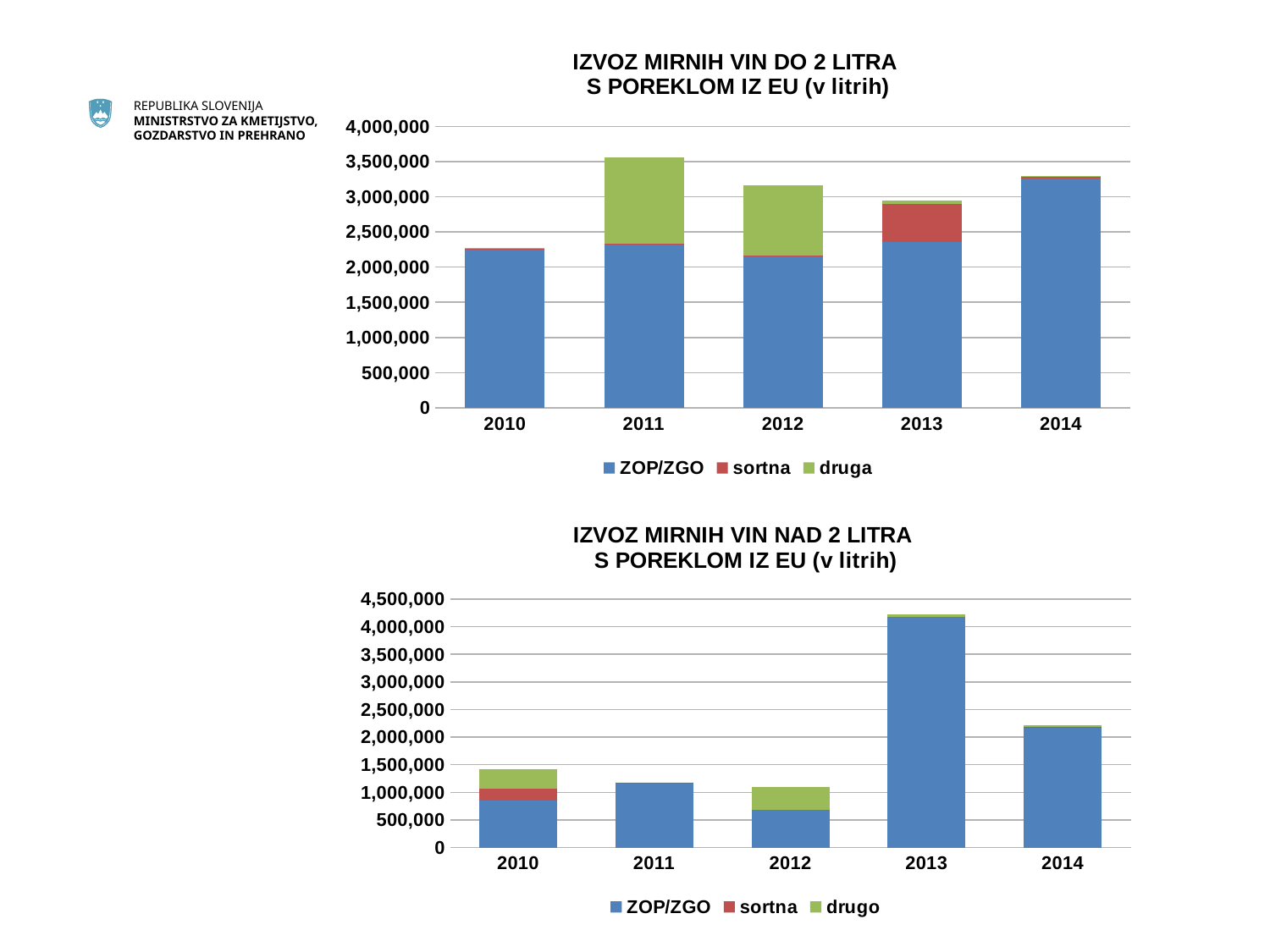
In the bottom chart (IZVOZ MIRNIH VIN NAD 2 LITRA), is the total bar for 2013 greater or less than 4,000,000? greater In the top chart (IZVOZ MIRNIH VIN DO 2 LITRA), is the total bar for 2014 greater or less than 3,000,000? greater In the bottom chart (IZVOZ MIRNIH VIN NAD 2 LITRA), which year has the highest total bar? 2013 In the top chart (IZVOZ MIRNIH VIN DO 2 LITRA), how many series does the legend list? 3 In the top chart (IZVOZ MIRNIH VIN DO 2 LITRA), which year has the larger total bar, 2011 or 2012? 2011 In the top chart (IZVOZ MIRNIH VIN DO 2 LITRA), which year has the lowest total bar? 2010 In the bottom chart (IZVOZ MIRNIH VIN NAD 2 LITRA), is the ZOP/ZGO value for 2012 greater or less than 1,000,000? less In the top chart (IZVOZ MIRNIH VIN DO 2 LITRA), how many years are shown on the x axis? 5 What type of chart is the top chart titled "IZVOZ MIRNIH VIN DO 2 LITRA S POREKLOM IZ EU (v litrih)"? Stacked bar chart In the bottom chart (IZVOZ MIRNIH VIN NAD 2 LITRA), what are the three series listed in the legend? ZOP/ZGO, sortna, drugo In the top chart (IZVOZ MIRNIH VIN DO 2 LITRA), which year has the highest total bar? 2011